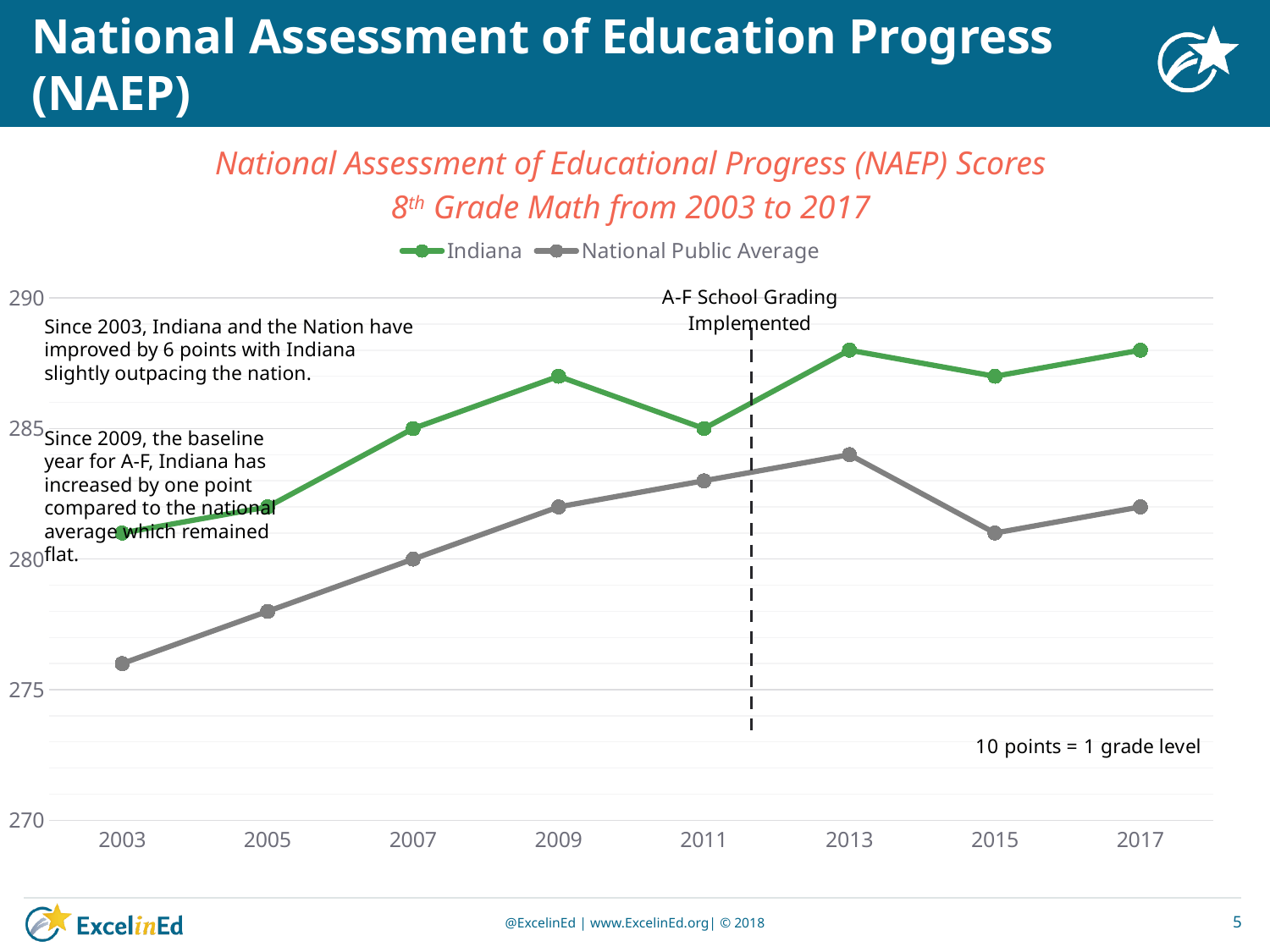
Is the value for the National Public Average in 2003 greater or less than 280? less Is the value for the National Public Average in 2013 greater or less than 285? less Is the value for Indiana in 2009 greater or less than 285? greater In 2011, which series has the higher value, Indiana or National Public Average? Indiana Does the National Public Average rise or fall from 2003 to 2013? Rise Which year has the highest value for the National Public Average? 2013 According to the annotation on the chart, how many points equal one grade level? 10 points How many series does the legend list? 2 Which year has the lowest value for Indiana? 2003 How many years are plotted along the x axis? 8 What kind of chart is shown on the slide? Line chart Which year has the lowest value for the National Public Average? 2003